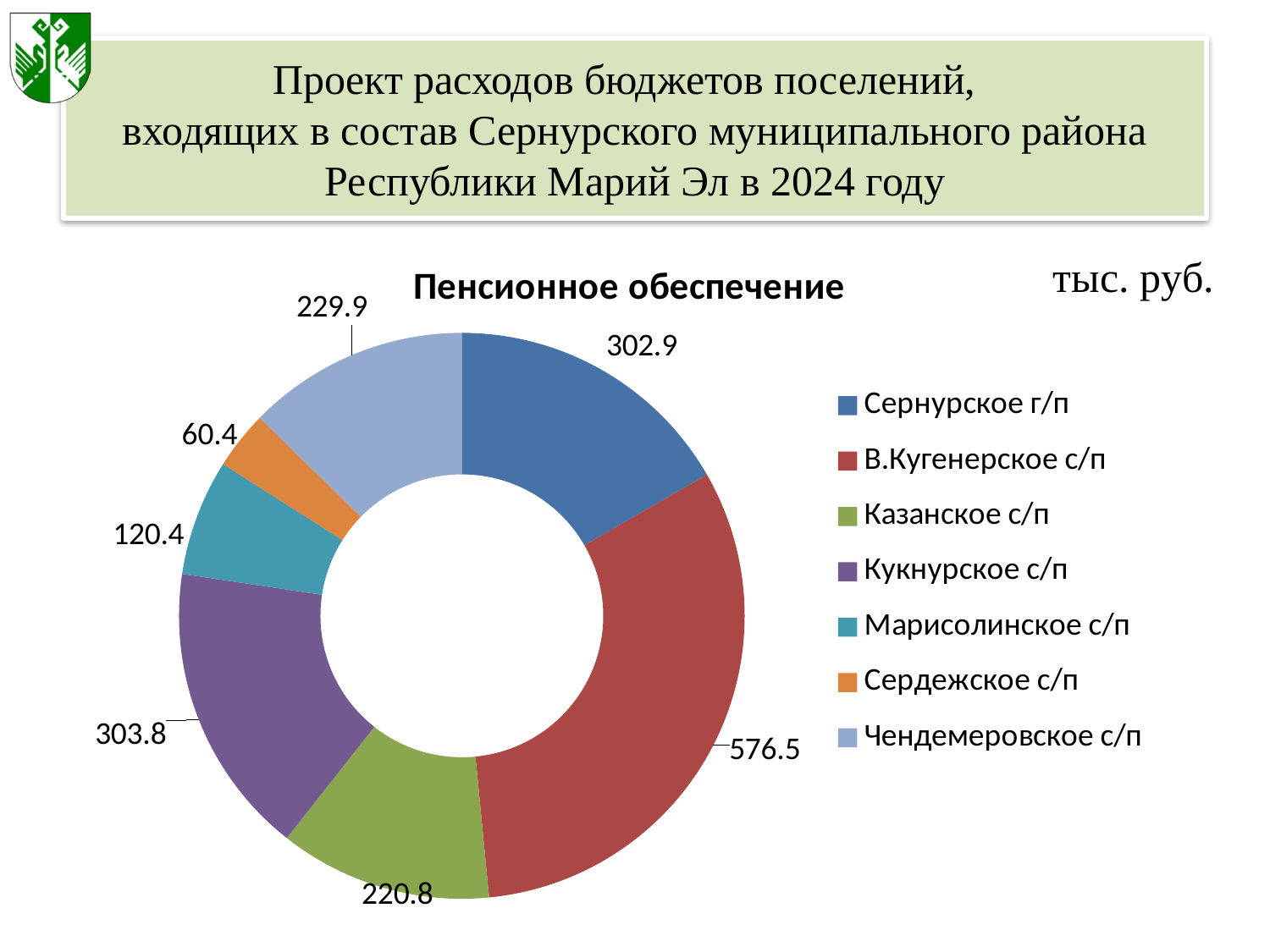
How many categories are shown in the Пенсионное обеспечение chart? 7 What is the difference between the values for Чендемеровское с/п and Казанское с/п in the Пенсионное обеспечение chart? 9.1 Which category has the smallest value in the Пенсионное обеспечение chart? Сердежское с/п Which is larger in the Пенсионное обеспечение chart: Казанское с/п or Марисолинское с/п? Казанское с/п What kind of chart is the Пенсионное обеспечение chart? Doughnut (pie) chart What is the value for Чендемеровское с/п in the Пенсионное обеспечение chart? 229.9 What unit is indicated for the values in the Пенсионное обеспечение chart? тыс. руб. What is the total of all values in the Пенсионное обеспечение chart? 1814.7 Which category has the largest value in the Пенсионное обеспечение chart? В.Кугенерское с/п What is the value for Марисолинское с/п in the Пенсионное обеспечение chart? 120.4 What is the value for В.Кугенерское с/п in the Пенсионное обеспечение chart? 576.5 What is the difference between the values for В.Кугенерское с/п and Сернурское г/п in the Пенсионное обеспечение chart? 273.6